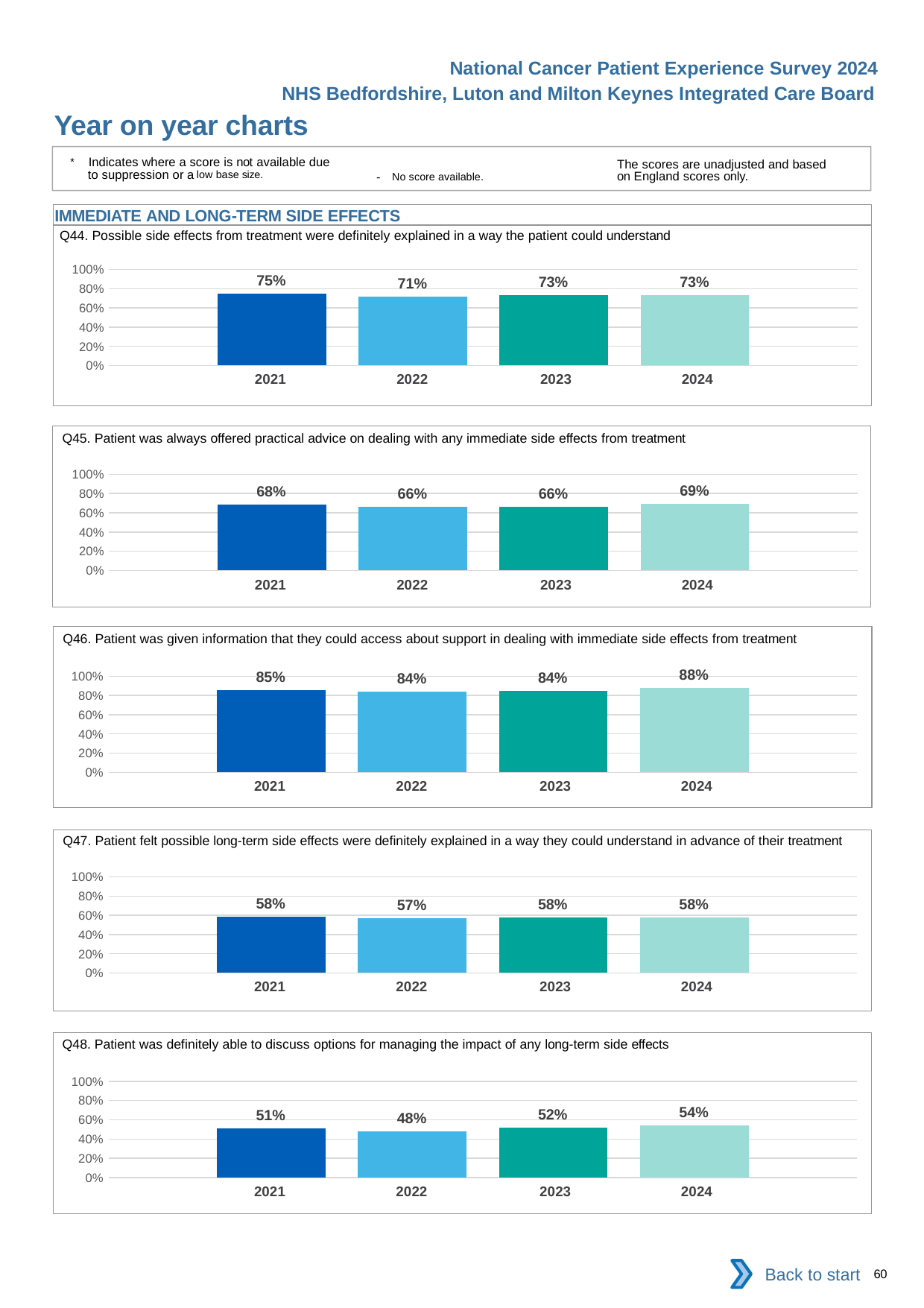
In the Q46 chart, which year has the highest value? 2024 In the Q45 chart, what is the difference between the 2021 and 2022 values? 2 percentage points In the Q46 chart, what is the value for 2022? 84% In the Q45 chart, what is the value for 2024? 69% In the Q48 chart, is the value for 2023 larger than the value for 2022? Yes How many years are shown in the Q44 chart? 4 In the Q48 chart, what is the difference between the 2024 and 2021 values? 3 percentage points In the Q44 chart, what is the value for 2021? 75% In the Q47 chart, is the value for 2024 greater or less than 60%? less In the Q48 chart, which year has the lowest value? 2022 In the Q44 chart, which year has the lowest value? 2022 In the Q47 chart, what is the value for 2022? 57%